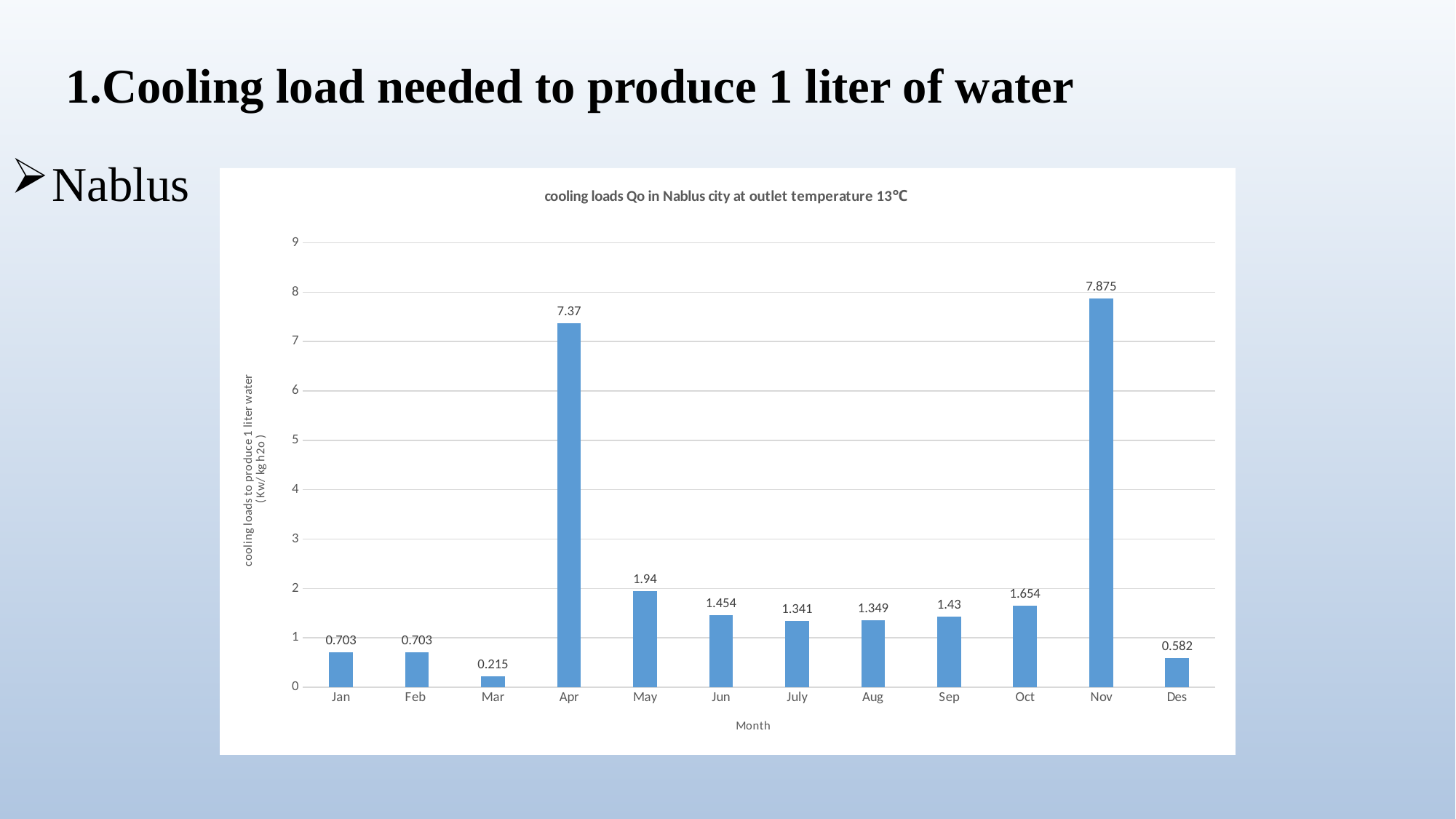
What is the cooling load value for Oct? 1.654 What is the difference between the cooling load values for Nov and Apr? 0.505 What is the cooling load value for Apr? 7.37 Which month has the lowest cooling load? Mar Which month has the highest cooling load? Nov Which has a larger cooling load, May or Des? May What is the cooling load value for Mar? 0.215 What kind of chart is shown on the slide? bar chart Is the value for Apr greater or less than 7? greater What is the cooling load value for Nov? 7.875 How many months are shown on the x axis? 12 What is the title of the chart? cooling loads Qo in Nablus city at outlet temperature 13℃